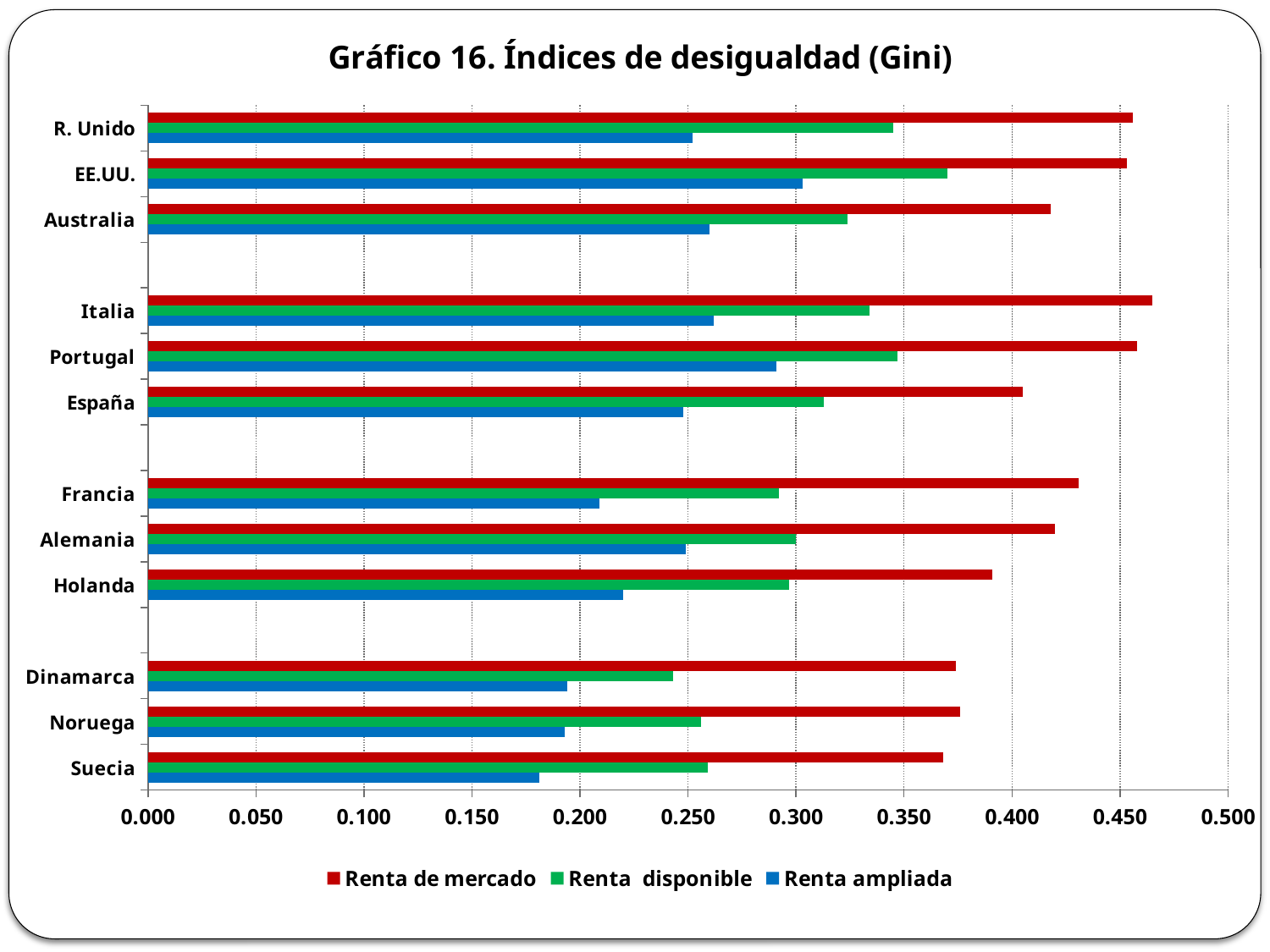
What kind of chart is shown on the slide? bar chart Is the value of Renta de mercado for Italia greater or less than 0.450? greater Is the value of Renta disponible for EE.UU. greater or less than 0.350? greater Is the value of Renta de mercado for Francia greater or less than 0.400? greater How many countries are shown on the chart? 12 Which is larger, the Renta ampliada value for Francia or for Alemania? Alemania Which country has the highest value for Renta ampliada? EE.UU. What is the title of the chart? Gráfico 16. Índices de desigualdad (Gini) Which country has the highest value for Renta disponible? EE.UU. How many series does the legend list? 3 Which country has the lowest value for Renta disponible? Dinamarca